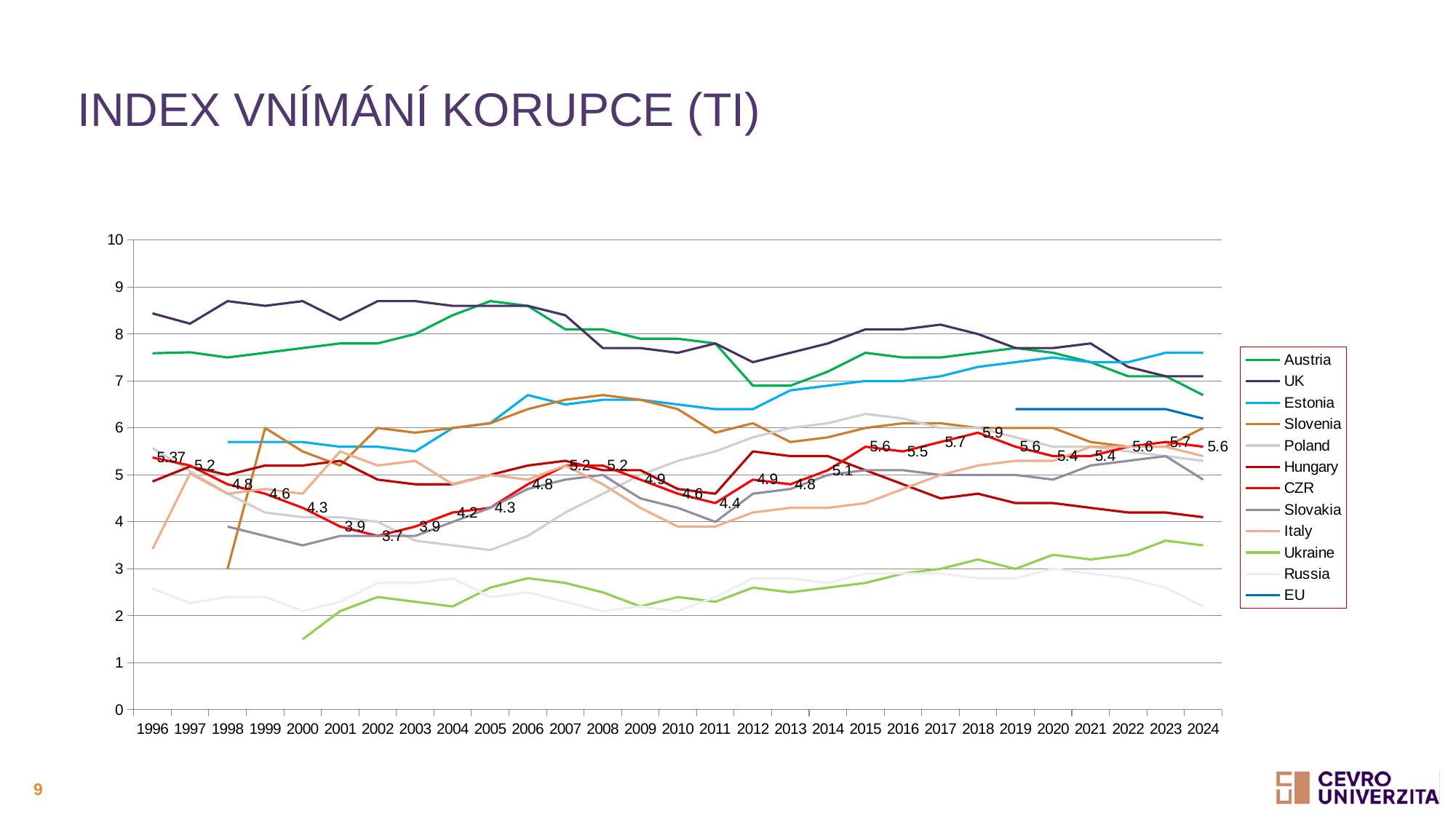
Which is larger in 2024, the value for Austria or the value for Ukraine? Austria Is the value for Russia in 2024 greater or less than 3? less How many series does the legend list? 12 What is the title of the chart? INDEX VNÍMÁNÍ KORUPCE (TI) What is the value for CZR in 2018? 5.9 In which year does the CZR series reach its highest value? 2018 What is the value for CZR in 2002? 3.7 In which year does the CZR series reach its lowest value? 2002 What is the difference between the CZR value in 2018 and in 2002? 2.2 How many years are shown on the x axis? 29 What kind of chart is shown on the slide? line chart What is the value for CZR in 1996? 5.37